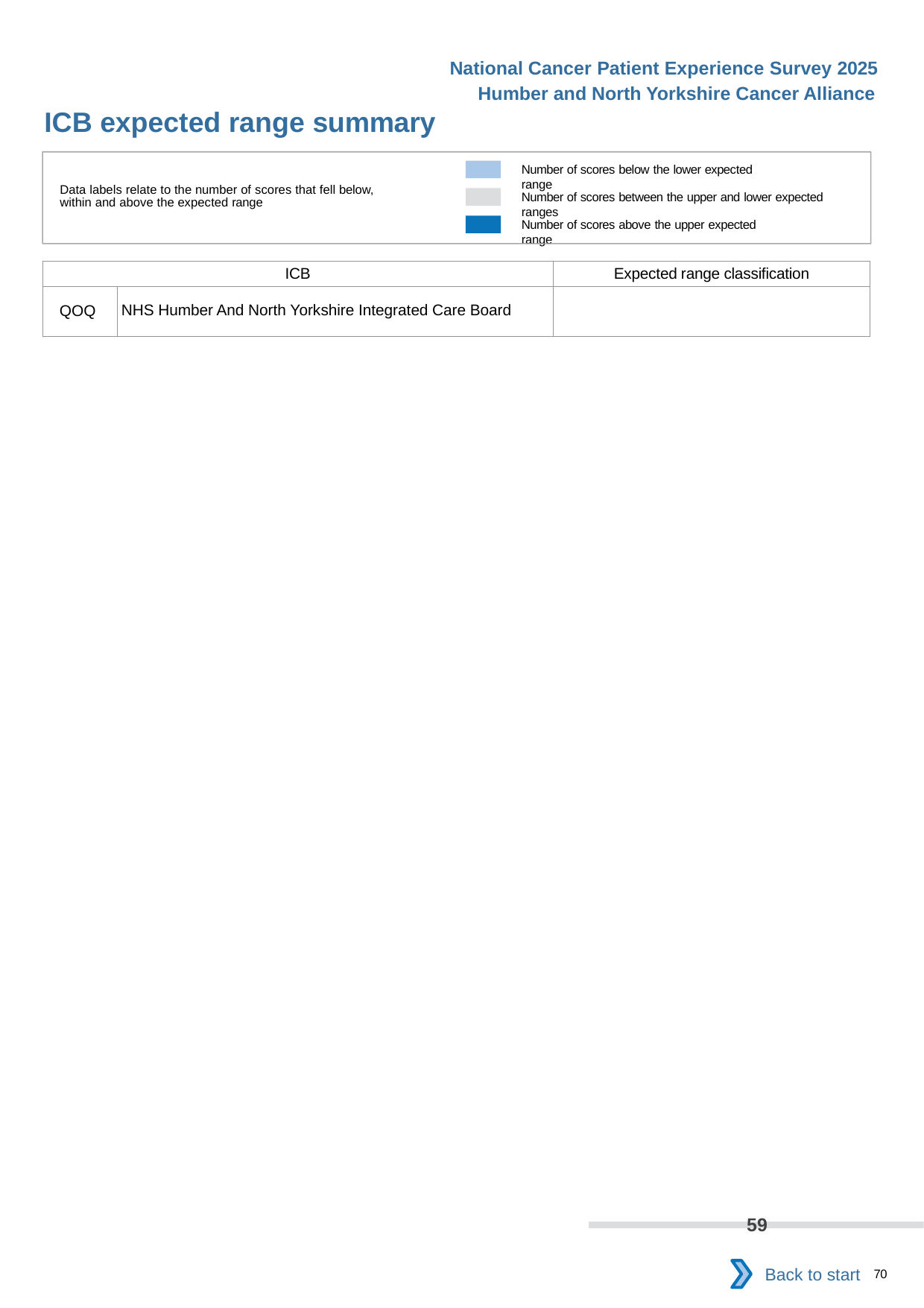
According to the legend, what does the grey colour represent? Number of scores between the upper and lower expected ranges According to the legend, what does the dark blue colour represent? Number of scores above the upper expected range How many entries does the legend in the key box list? 3 What value is printed as the data label on the grey bar near the bottom of the slide? 59 Is the value printed on the grey bar greater or less than 50? greater